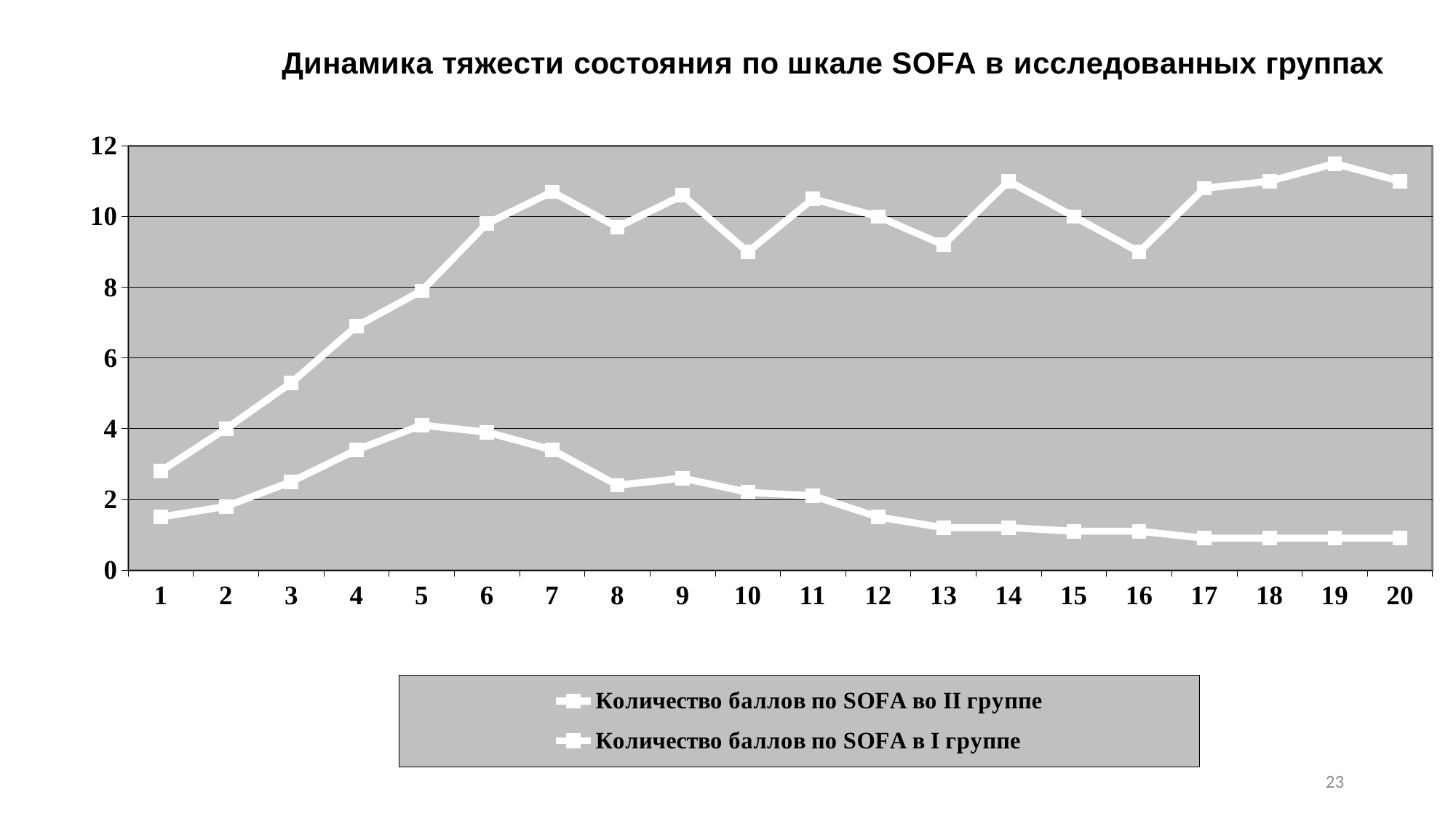
Is the value of the upper line at point 19 greater or less than 10? greater What are the two series named in the legend? Количество баллов по SOFA во II группе; Количество баллов по SOFA в I группе How many points are there along the x axis? 20 How many series does the legend list? 2 Is the value of the upper line at point 3 greater or less than 6? less Is the value of the upper line at point 1 greater or less than 2? greater What is the title of the chart? Динамика тяжести состояния по шкале SOFA в исследованных группах Does the lower line rise or fall from point 5 to point 20? fall At which x-axis point does the upper line have its lowest value? 1 What kind of chart is shown on the slide? line chart At which x-axis point does the upper line reach its highest value? 19